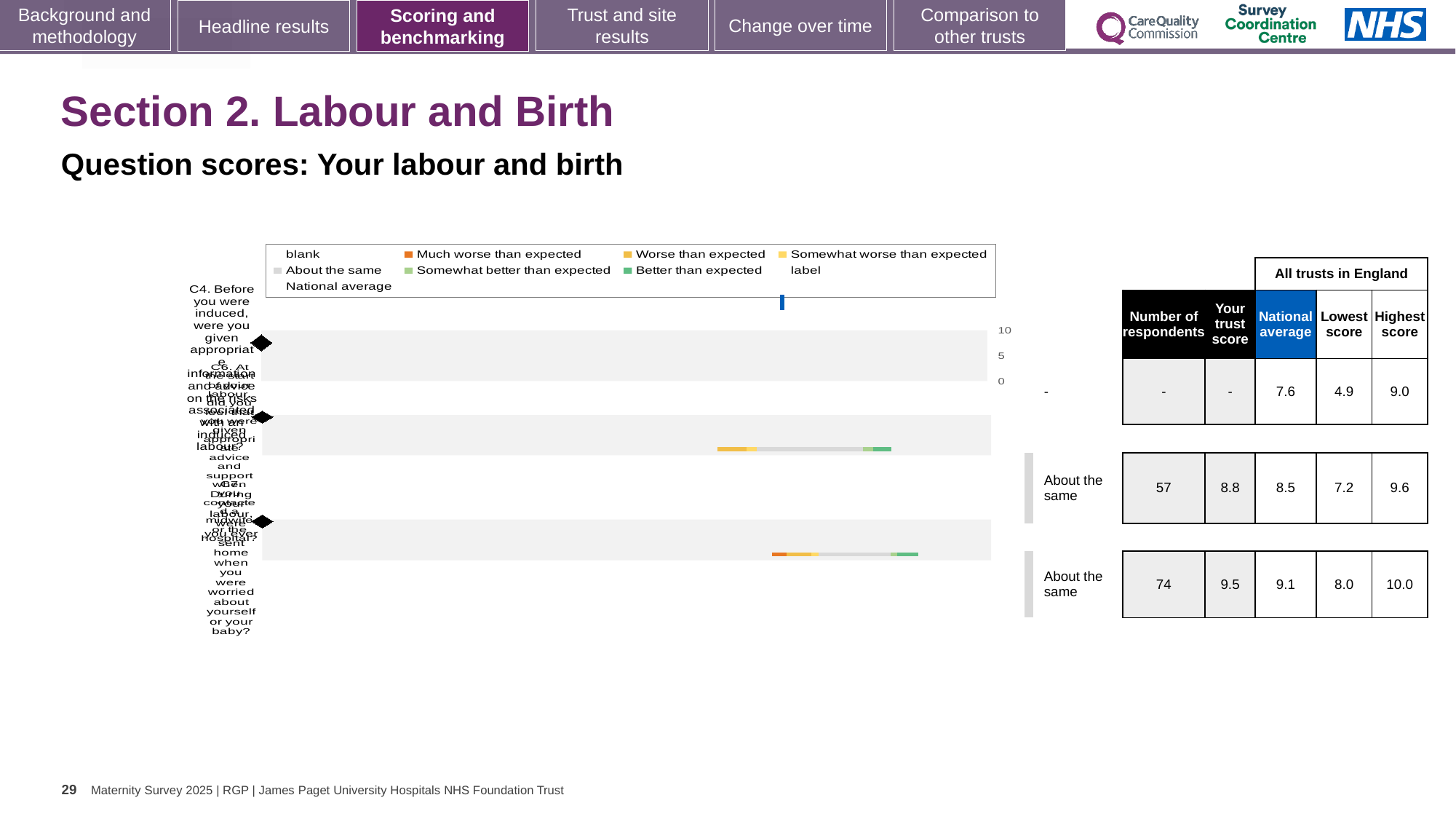
For the second row of the table, what is the difference between the trust score and the national average? 0.3 For the third row of the table, which is larger: the trust score or the national average? trust score In the table next to the chart, what is the lowest score for the first row (question C4)? 4.9 Which row of the table has the highest number of respondents? the third row In the table next to the chart, what is the trust score for the third row? 9.5 In the table next to the chart, what is the national average for the first row (question C4)? 7.6 How many question rows (bars) does the chart show? 3 What kind of chart is shown on the slide? bar chart What is the highest tick value shown on the chart's axis? 10 For the first row of the table, what is the difference between the highest score and the lowest score? 4.1 In the table next to the chart, what is the highest score for the third row? 10.0 In the table next to the chart, how many respondents are listed for the second row? 57